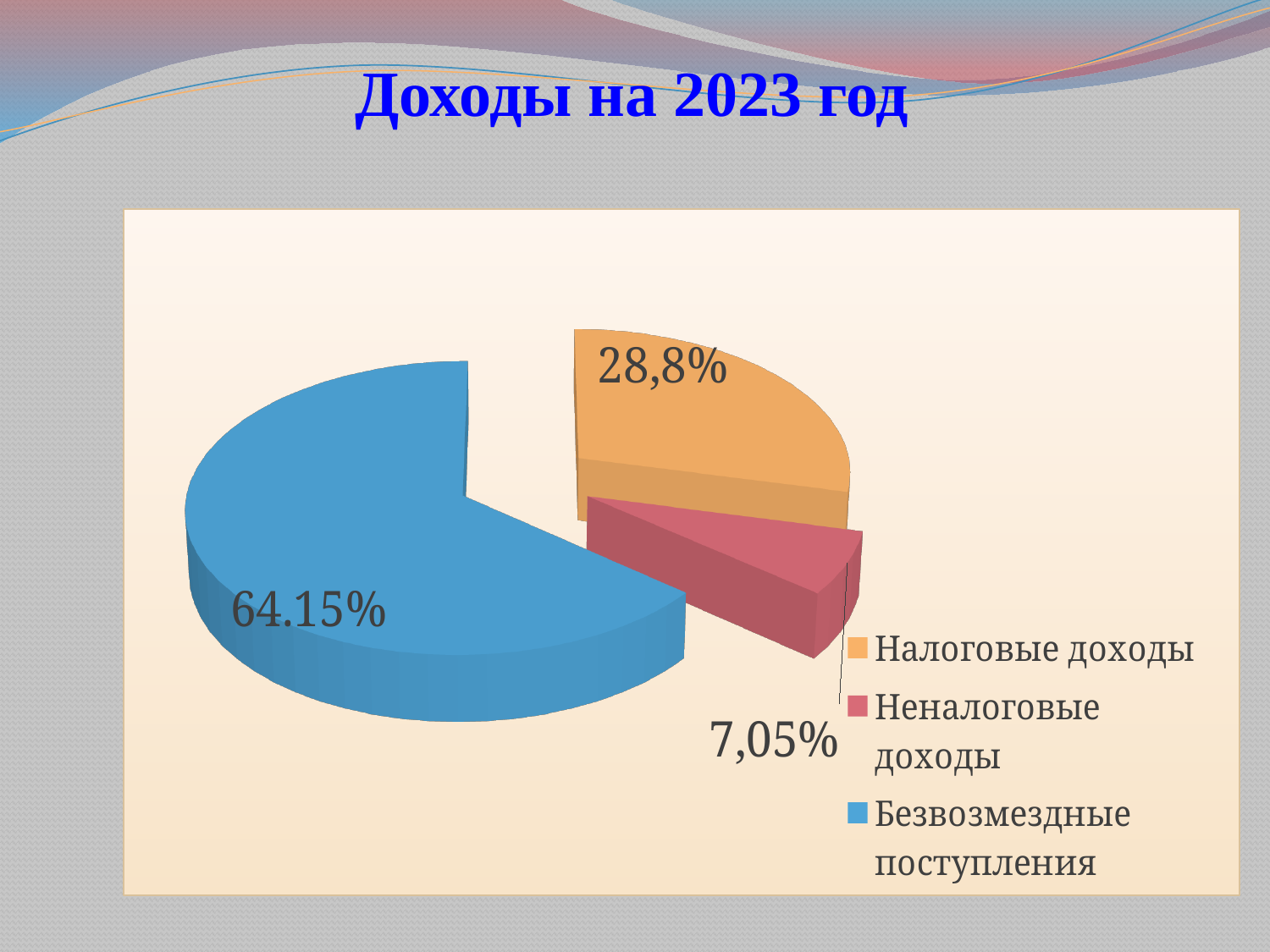
Which category has the largest share of the pie? Безвозмездные поступления How many entries does the legend list? 3 What kind of chart is shown on the slide? pie chart What is the title of the chart on the slide? Доходы на 2023 год What share of the pie is Налоговые доходы? 28,8% By how many percentage points does the share for Налоговые доходы exceed the share for Неналоговые доходы? 21,75% Which colour represents Безвозмездные поступления in the pie chart? blue Which category has the smallest share of the pie? Неналоговые доходы What share of the pie is Неналоговые доходы? 7,05% Which is larger, the share for Налоговые доходы or the share for Неналоговые доходы? Налоговые доходы How many slices does the pie chart have? 3 What share of the pie is Безвозмездные поступления? 64.15%